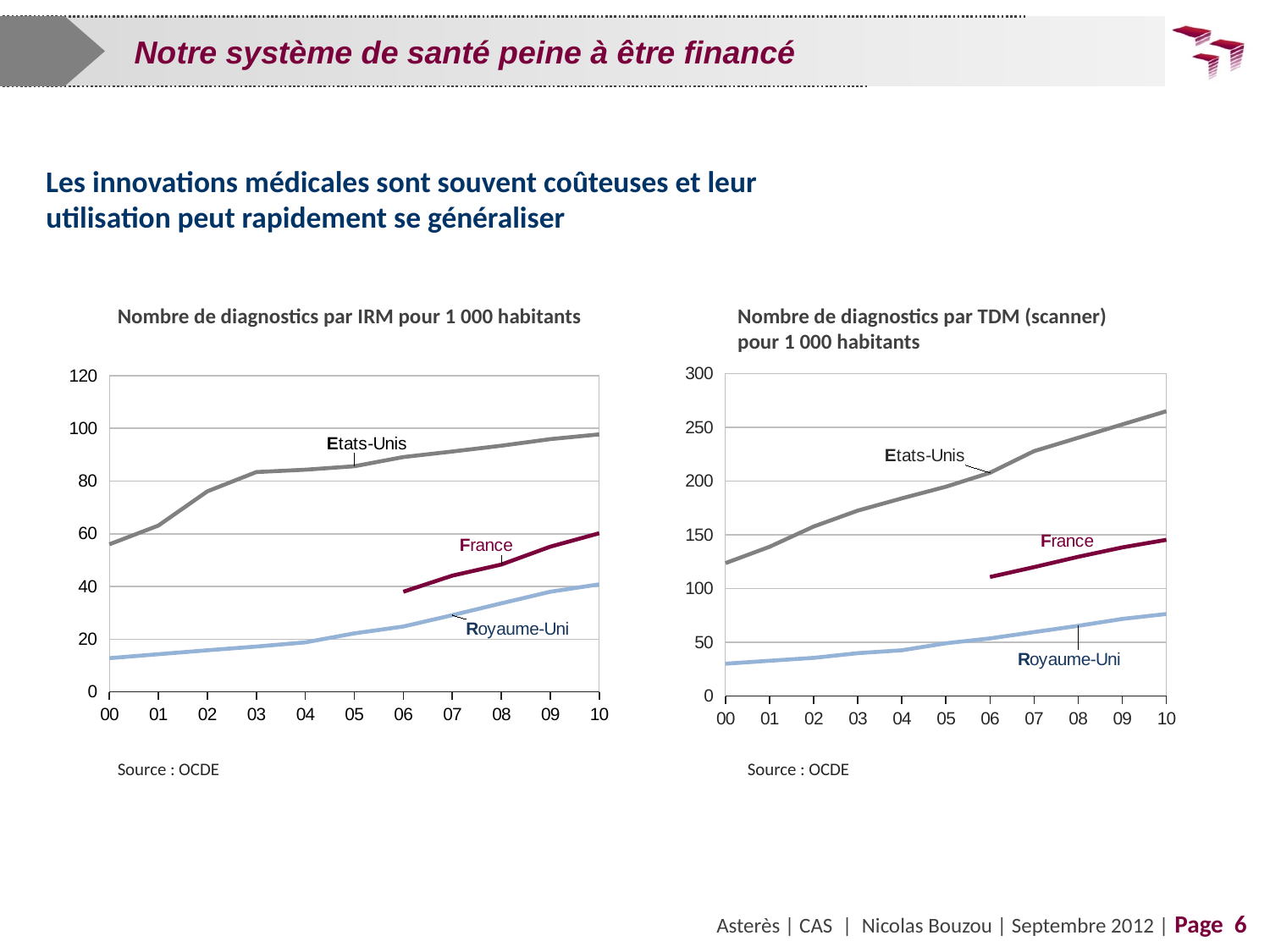
What kind of chart is the chart titled "Nombre de diagnostics par IRM pour 1 000 habitants"? Line chart In the right chart (TDM scanner), is the value for Royaume-Uni in 10 greater or less than 50? greater In the left chart (IRM), is the value for Royaume-Uni in 00 greater or less than 20? less In the left chart (IRM), does the Royaume-Uni line rise or fall from 00 to 10? Rises In the right chart (TDM scanner), which country has the lowest number of diagnostics in 10? Royaume-Uni What source is cited under both charts? OCDE In the left chart (IRM), which country has the highest number of diagnostics in 10? Etats-Unis In the right chart (TDM scanner), which is larger in 10: France or Royaume-Uni? France In the right chart (TDM scanner), how many years are shown on the x axis? 11 In the left chart (IRM), how many countries are plotted? 3 In the right chart (TDM scanner), is the value for Etats-Unis in 10 greater or less than 250? greater